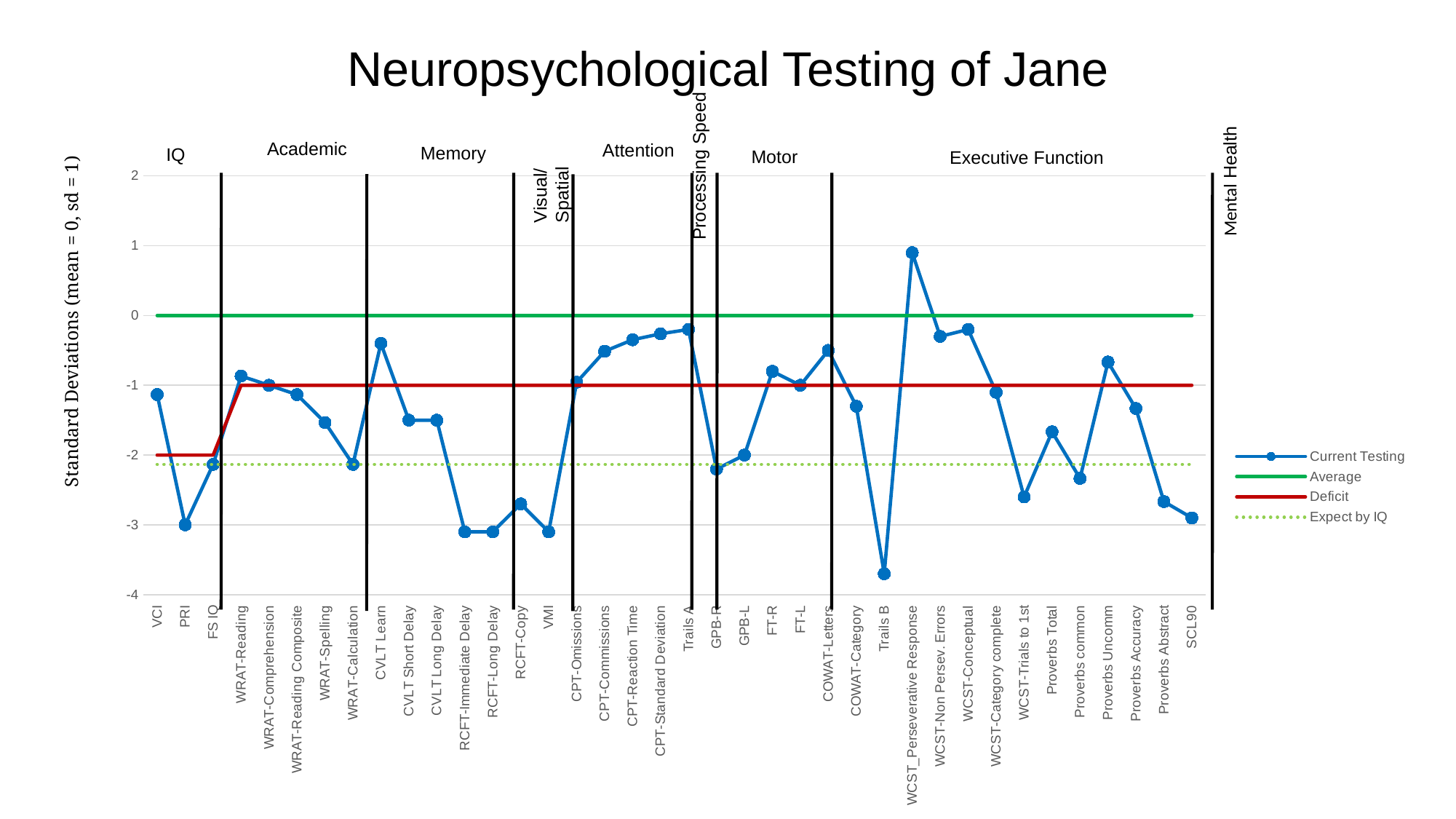
What is the title of the chart? Neuropsychological Testing of Jane How many series does the legend list? 4 What kind of chart is shown on the slide? line chart Which test has the lowest value in the Current Testing series? Trails B Which test has the highest value in the Current Testing series? WCST_Perseverative Response How many test categories are plotted along the x axis? 38 Which has the larger Current Testing value, Trails A or Trails B? Trails A Is the Current Testing value for Trails B greater or less than -3? less Within the Attention section, do the Current Testing values rise or fall from CPT-Omissions to Trails A? rise Which has the larger Current Testing value, CVLT Learn or CVLT Short Delay? CVLT Learn Is the Current Testing value for WCST_Perseverative Response greater or less than 0? greater